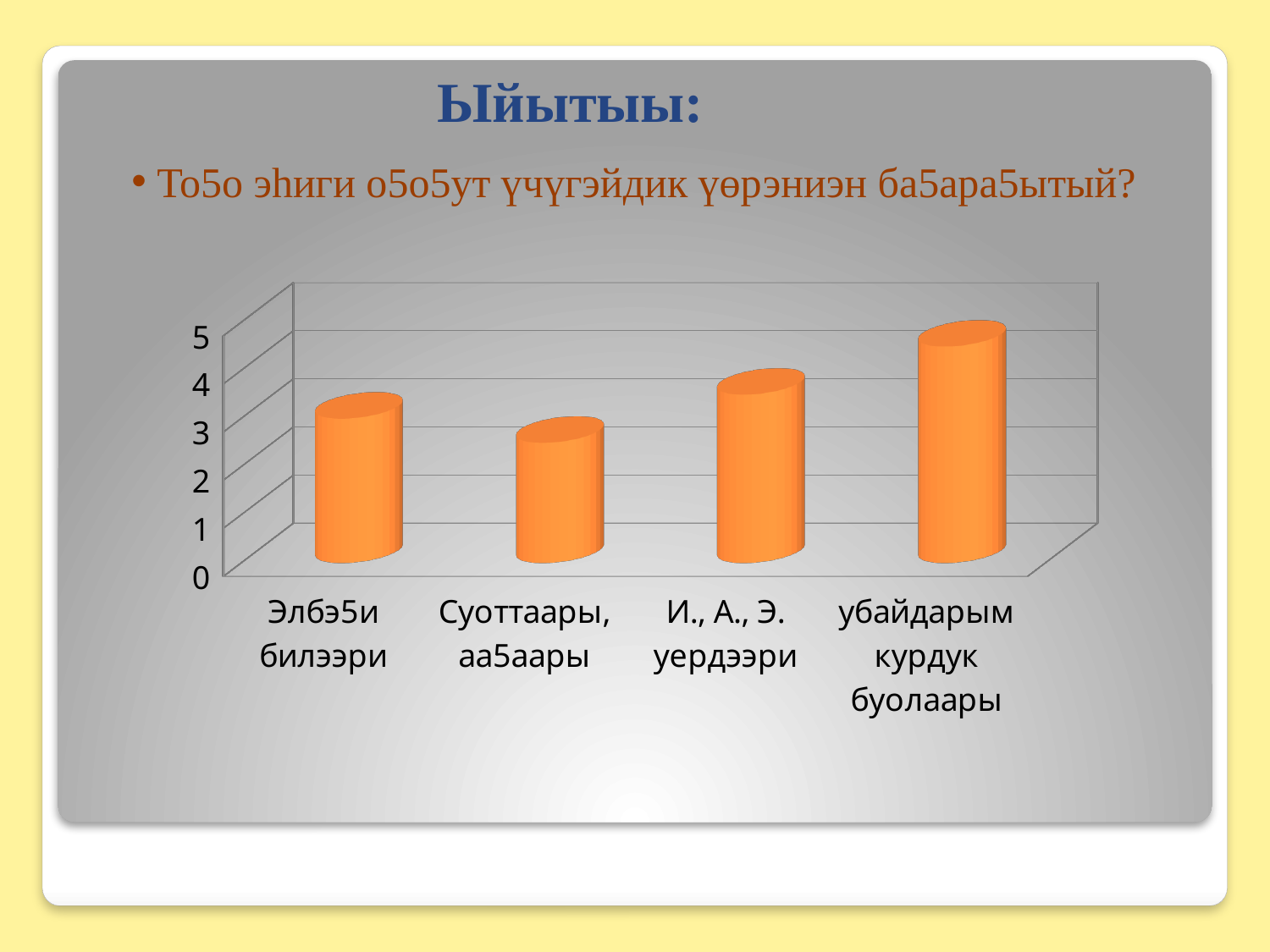
Which category has the highest bar in the chart? убайдарым курдук буолаары Is the value for Элбэ5и билээри greater or less than 2? greater Is the value for убайдарым курдук буолаары greater or less than 4? greater Which is larger, the value for И., А., Э. уердээри or the value for убайдарым курдук буолаары? убайдарым курдук буолаары What is the highest value shown on the vertical axis of the chart? 5 What kind of chart is shown on the slide? bar chart Is the value for Суоттаары, аа5аары greater or less than 1? greater What colour are the bars in the chart? orange How many categories are shown on the x axis of the chart? 4 Which is larger, the value for Элбэ5и билээри or the value for Суоттаары, аа5аары? Элбэ5и билээри Which category has the lowest bar in the chart? Суоттаары, аа5аары